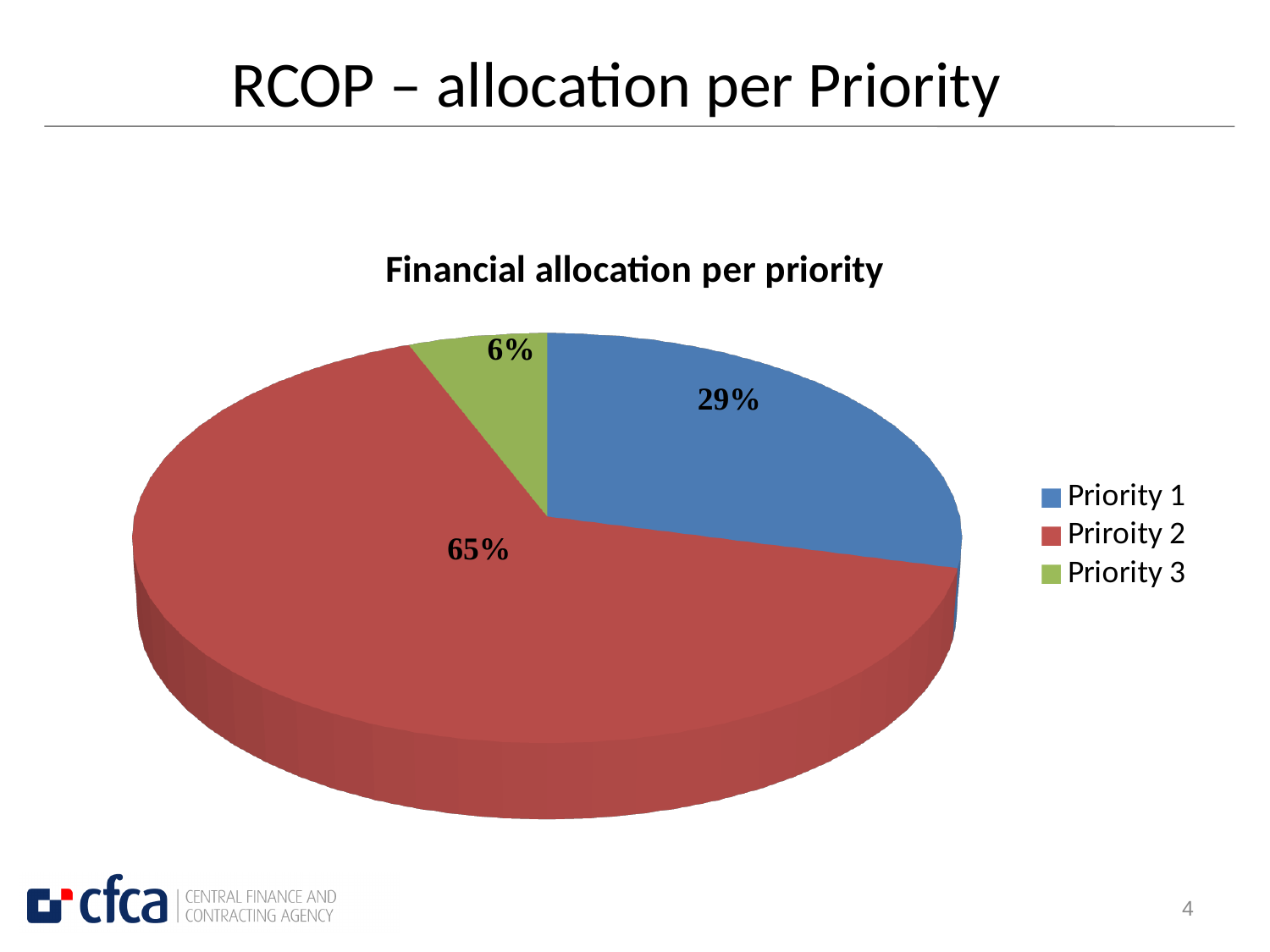
What is the title of the chart? Financial allocation per priority How many slices does the pie chart have? 3 What share of the pie does Priroity 2 represent? 65% Which colour represents Priority 3 in the legend? Green Which priority has the smallest share of the financial allocation? Priority 3 What is the difference in percentage points between the shares of Priority 1 and Priority 3? 23 What share of the pie does Priority 1 represent? 29% What share of the pie does Priority 3 represent? 6% Which has a larger share, Priority 1 or Priority 3? Priority 1 Which priority has the largest share of the financial allocation? Priroity 2 What is the difference in percentage points between the shares of Priroity 2 and Priority 1? 36 What kind of chart is shown on the slide? Pie chart